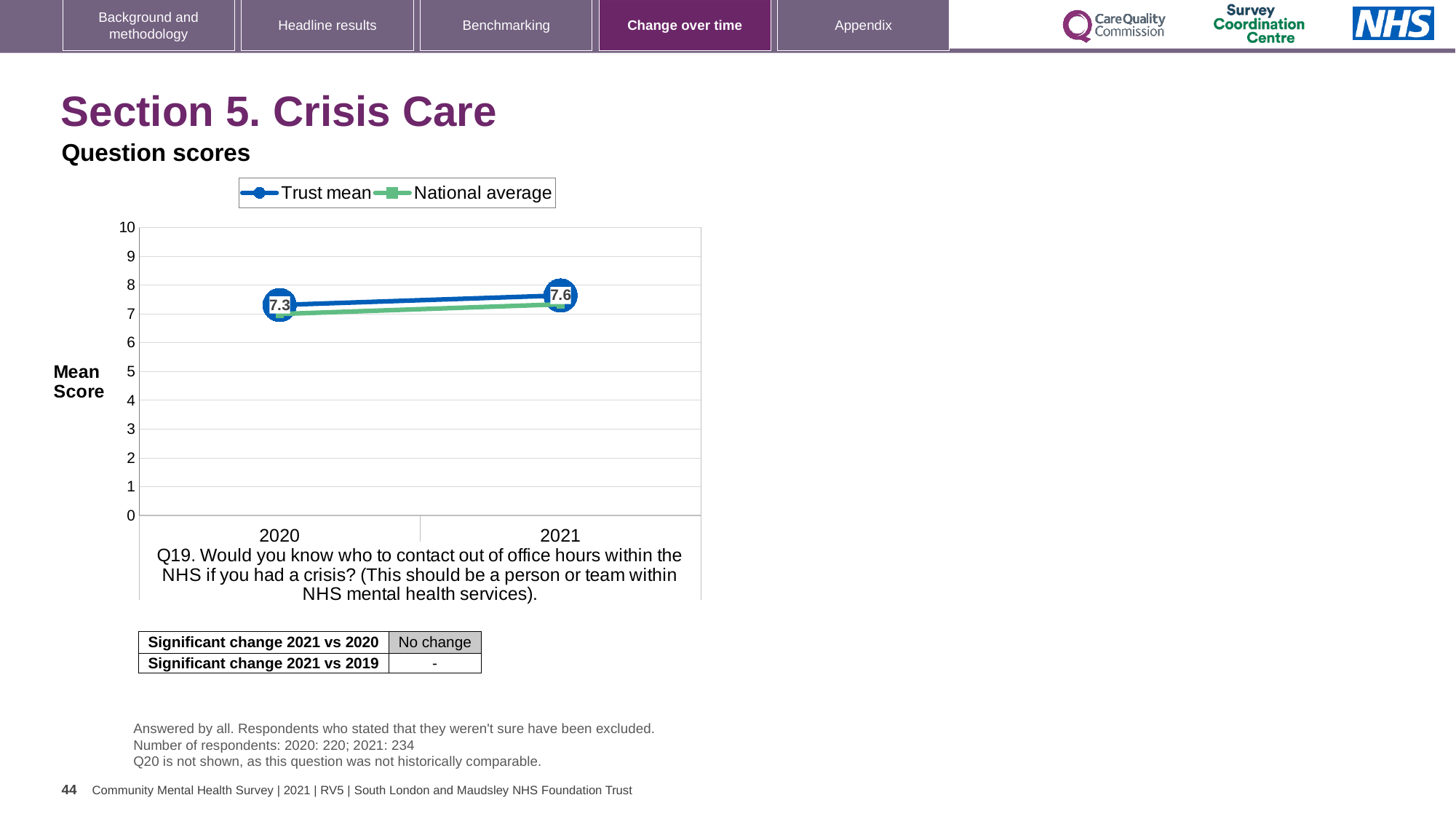
Which year has the higher Trust mean score, 2020 or 2021? 2021 Is the National average value for 2020 greater or less than 8? less Does the Trust mean rise or fall from 2020 to 2021? rise How many years are plotted on the x axis? 2 What is the Trust mean score for 2020? 7.3 What are the two series named in the legend? Trust mean and National average By how much did the Trust mean score change from 2020 to 2021? 0.3 What kind of chart is shown on the slide? line chart What is the label on the y axis of the chart? Mean Score What is the Trust mean score for 2021? 7.6 How many series does the legend list? 2 Is the Trust mean value for 2021 greater or less than 5? greater